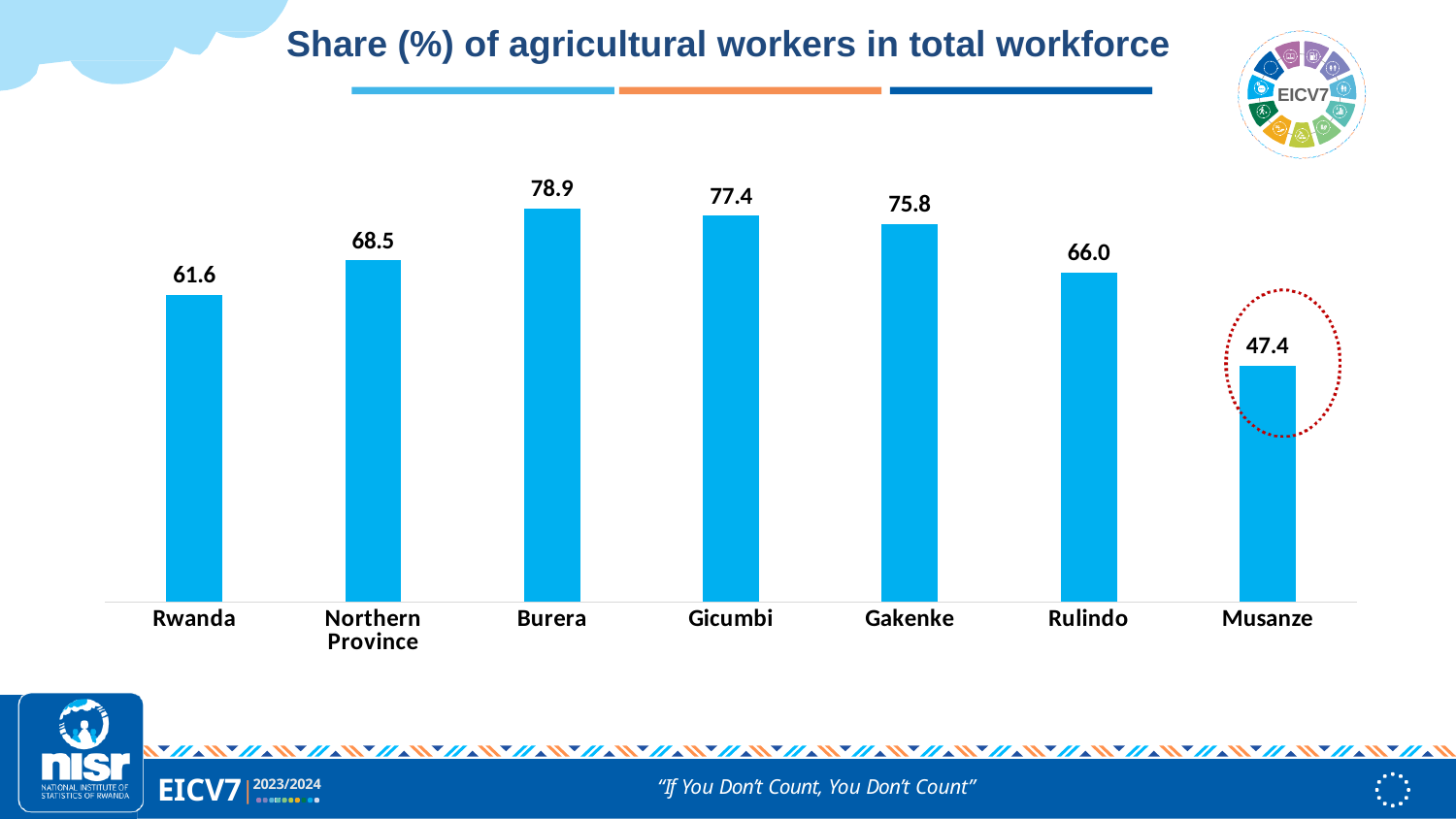
What is the value shown for Rwanda? 61.6 What is the difference between the values for Burera and Musanze? 31.5 What is the title of the chart? Share (%) of agricultural workers in total workforce Which category has the highest share of agricultural workers? Burera What is the value shown for Musanze? 47.4 Which has a larger value, Rulindo or Northern Province? Northern Province What is the value shown for Northern Province? 68.5 What is the share of agricultural workers in the total workforce for Burera? 78.9 How many categories are shown on the chart? 7 Which category has the lowest share of agricultural workers? Musanze What is the difference between the values for Gicumbi and Gakenke? 1.6 What kind of chart is shown on the slide? Bar chart